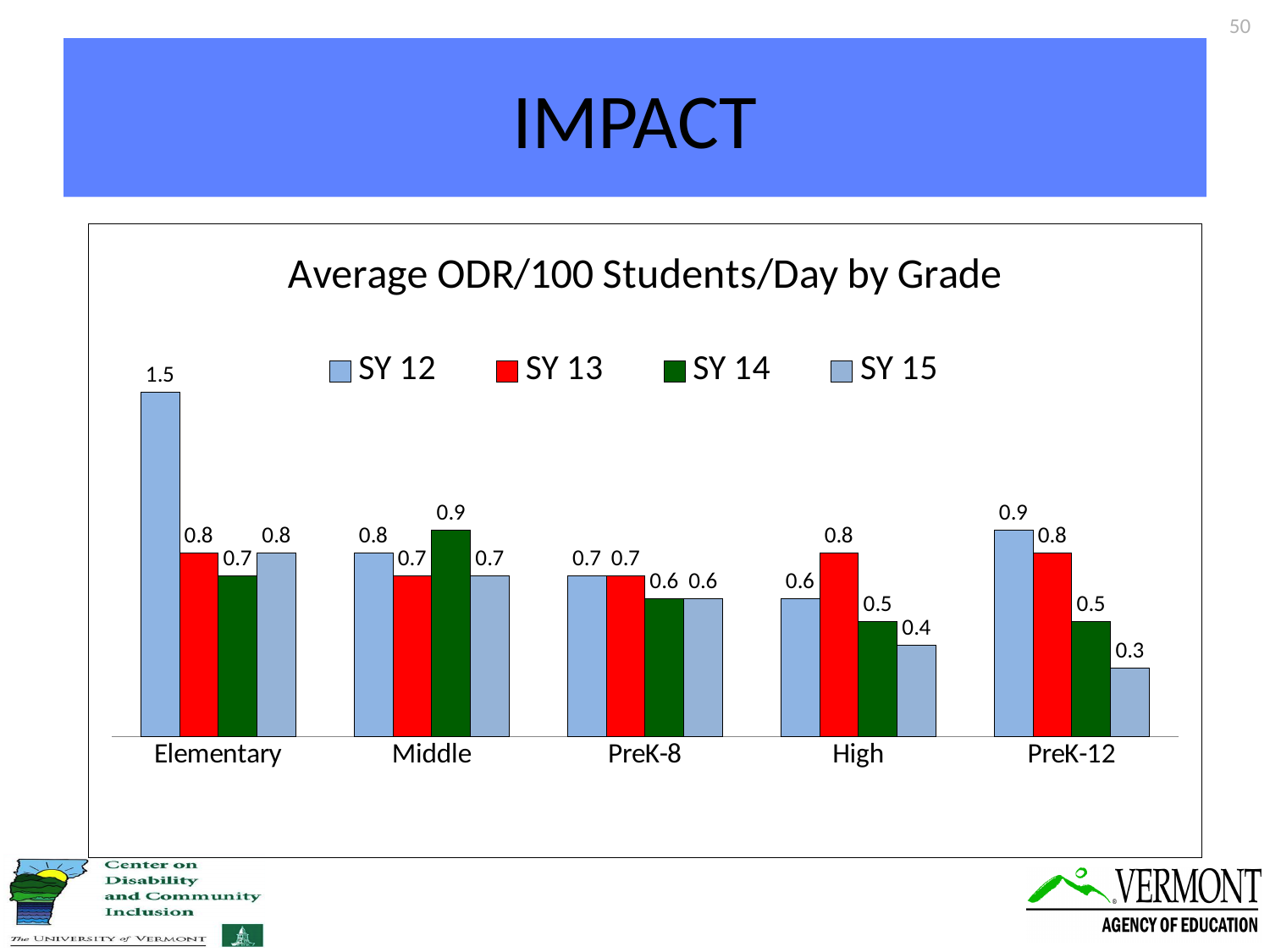
How many series does the legend list? 4 What is the SY 13 value for High? 0.8 Which grade category has the highest SY 12 value? Elementary Which grade category has the lowest SY 15 value? PreK-12 What is the difference between the SY 12 and SY 13 values for Elementary? 0.7 How many grade categories are shown on the x axis? 5 What is the SY 15 value for PreK-12? 0.3 What kind of chart is shown? Bar chart What is the SY 14 value for Middle? 0.9 Do the values for PreK-12 rise or fall from SY 12 to SY 15? Fall Which is larger for High: the SY 13 value or the SY 15 value? SY 13 What is the SY 12 value for Elementary? 1.5